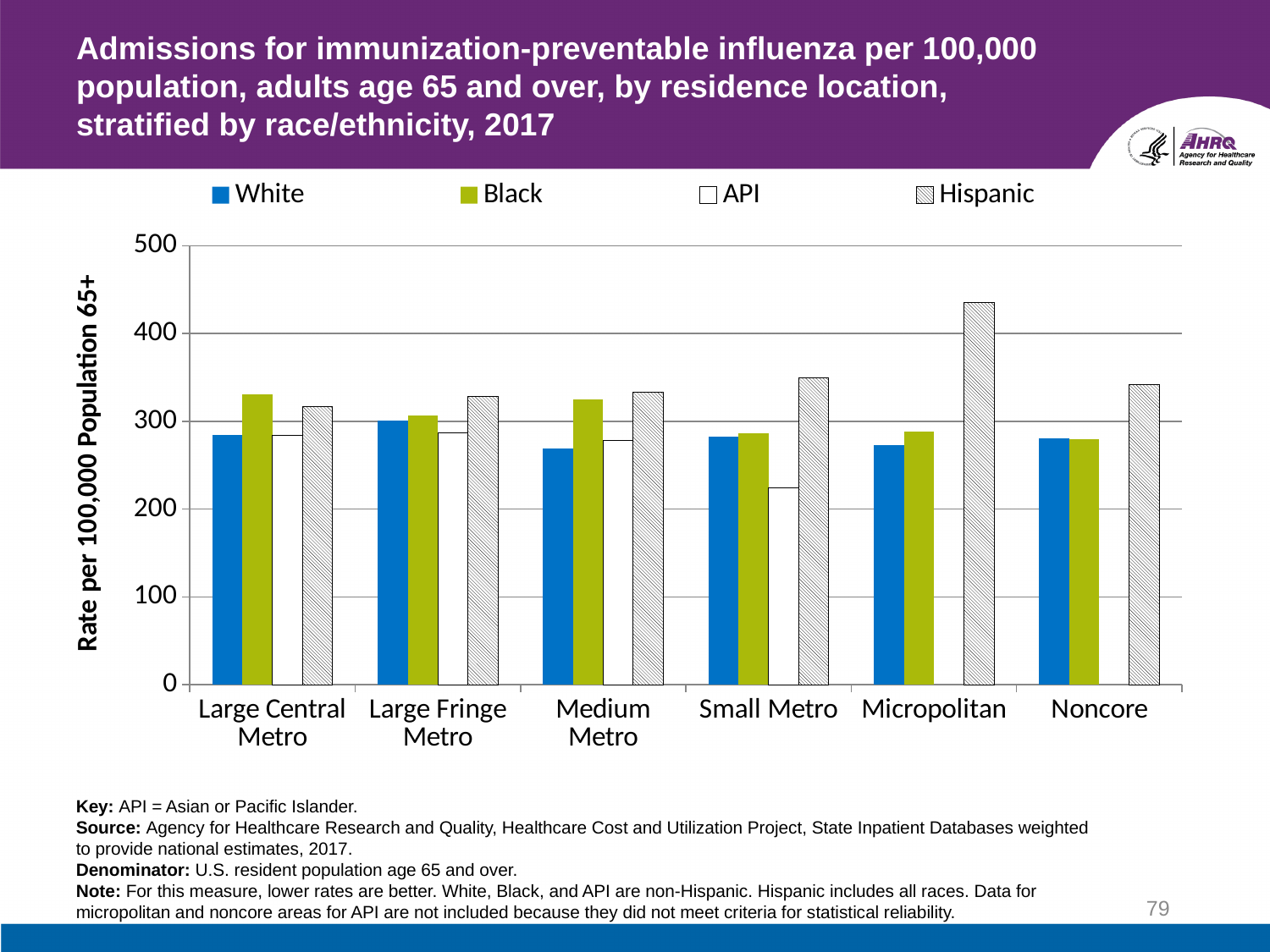
For Medium Metro, which is larger, the Hispanic rate or the White rate? Hispanic Which series has no bars for Micropolitan and Noncore? API What kind of chart is shown on the slide? bar chart How many series does the legend list? 4 Among the residence locations with an API bar, which has the lowest API rate? Small Metro Is the Black value for Large Central Metro greater or less than 300? greater For Large Central Metro, which is larger, the White rate or the Black rate? Black Is the White value for Medium Metro greater or less than 300? less For which residence location is the Hispanic rate highest? Micropolitan Is the Hispanic value for Micropolitan greater or less than 400? greater How many residence location categories are shown on the x axis? 6